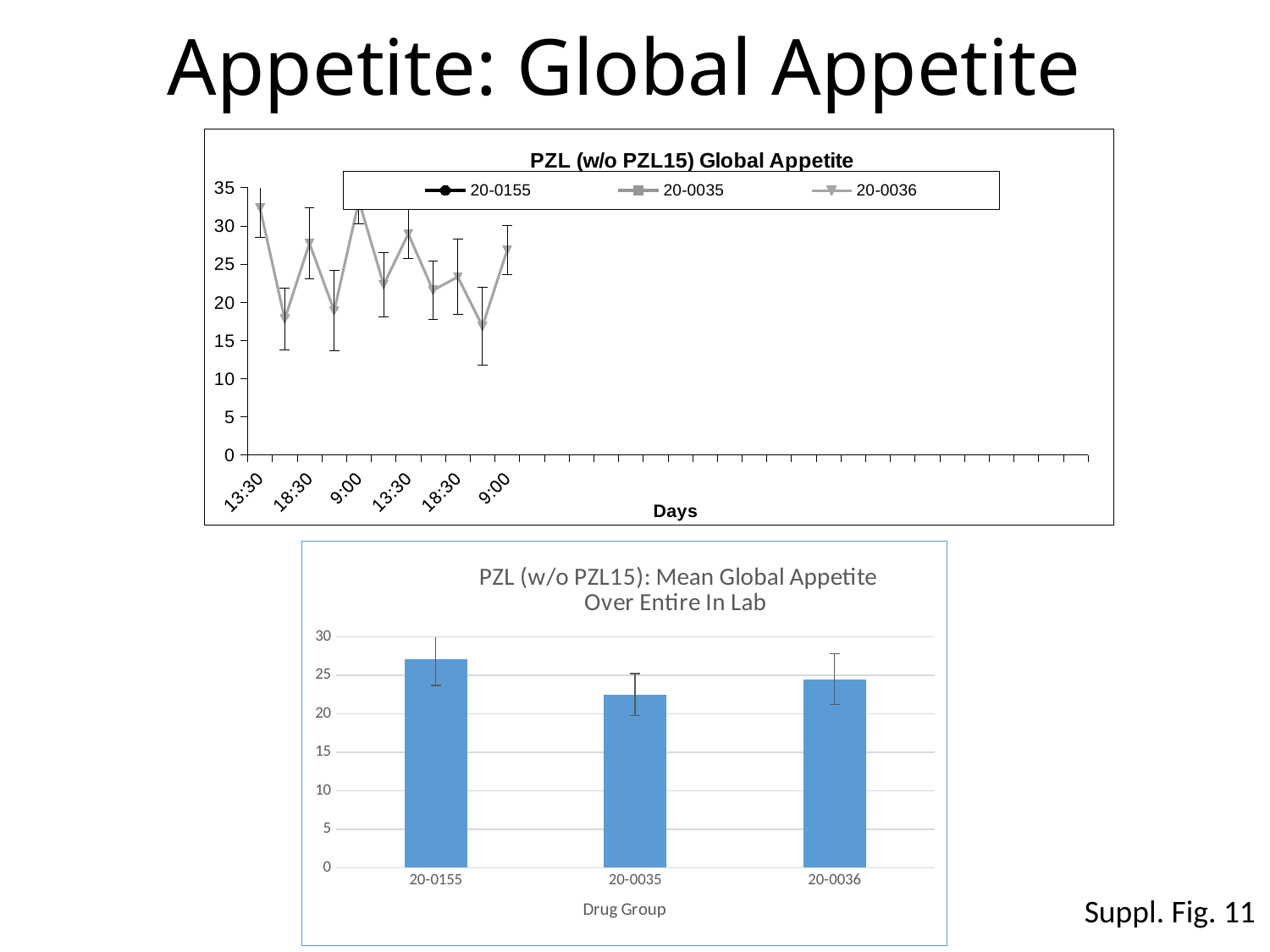
How many series does the legend of the top chart list? 3 In the bottom chart, which is larger, the bar for 20-0155 or the bar for 20-0035? 20-0155 What is the x-axis title of the bottom chart? Drug Group In the bottom chart, is the value for 20-0035 greater or less than 25? less In the bottom chart, is the value for 20-0036 greater or less than 20? greater What kind of chart is the bottom chart, 'PZL (w/o PZL15): Mean Global Appetite Over Entire In Lab'? bar chart In the bottom chart, which drug group has the lowest mean global appetite? 20-0035 How many drug groups are shown in the bottom chart? 3 In the bottom chart, is the value for 20-0155 greater or less than 25? greater What kind of chart is the top chart, 'PZL (w/o PZL15) Global Appetite'? line chart What is the x-axis title of the top chart? Days In the bottom chart, which drug group has the highest mean global appetite? 20-0155